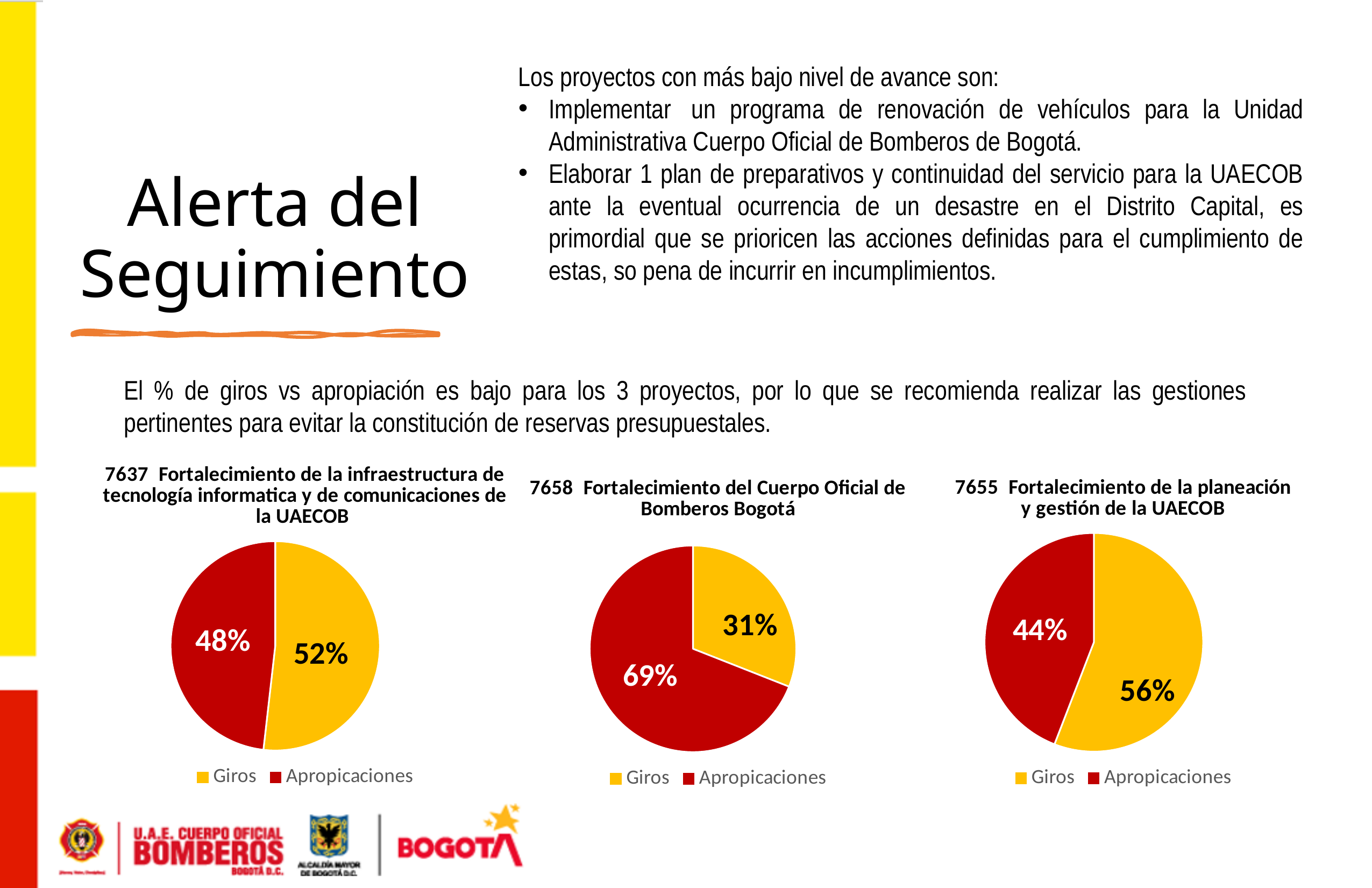
In the chart titled "7637 Fortalecimiento de la infraestructura de tecnología informatica y de comunicaciones de la UAECOB", what percentage is shown for Giros? 52% In the chart titled "7658 Fortalecimiento del Cuerpo Oficial de Bomberos Bogotá", what percentage is shown for Apropicaciones? 69% In the chart titled "7658 Fortalecimiento del Cuerpo Oficial de Bomberos Bogotá", what is the difference in percentage points between Apropicaciones and Giros? 38 In the chart titled "7637 Fortalecimiento de la infraestructura de tecnología informatica y de comunicaciones de la UAECOB", which is larger, Giros or Apropicaciones? Giros How many entries does the legend of the right-hand chart list? 2 In the chart titled "7658 Fortalecimiento del Cuerpo Oficial de Bomberos Bogotá", what percentage is shown for Giros? 31% In the chart titled "7655 Fortalecimiento de la planeación y gestión de la UAECOB", what percentage is shown for Apropicaciones? 44% In the chart titled "7655 Fortalecimiento de la planeación y gestión de la UAECOB", which slice is the smallest? Apropicaciones In the chart titled "7658 Fortalecimiento del Cuerpo Oficial de Bomberos Bogotá", which slice is the largest? Apropicaciones What type of chart is the middle chart on the slide? Pie chart In the chart titled "7637 Fortalecimiento de la infraestructura de tecnología informatica y de comunicaciones de la UAECOB", what percentage is shown for Apropicaciones? 48% In the chart titled "7655 Fortalecimiento de la planeación y gestión de la UAECOB", what percentage is shown for Giros? 56%